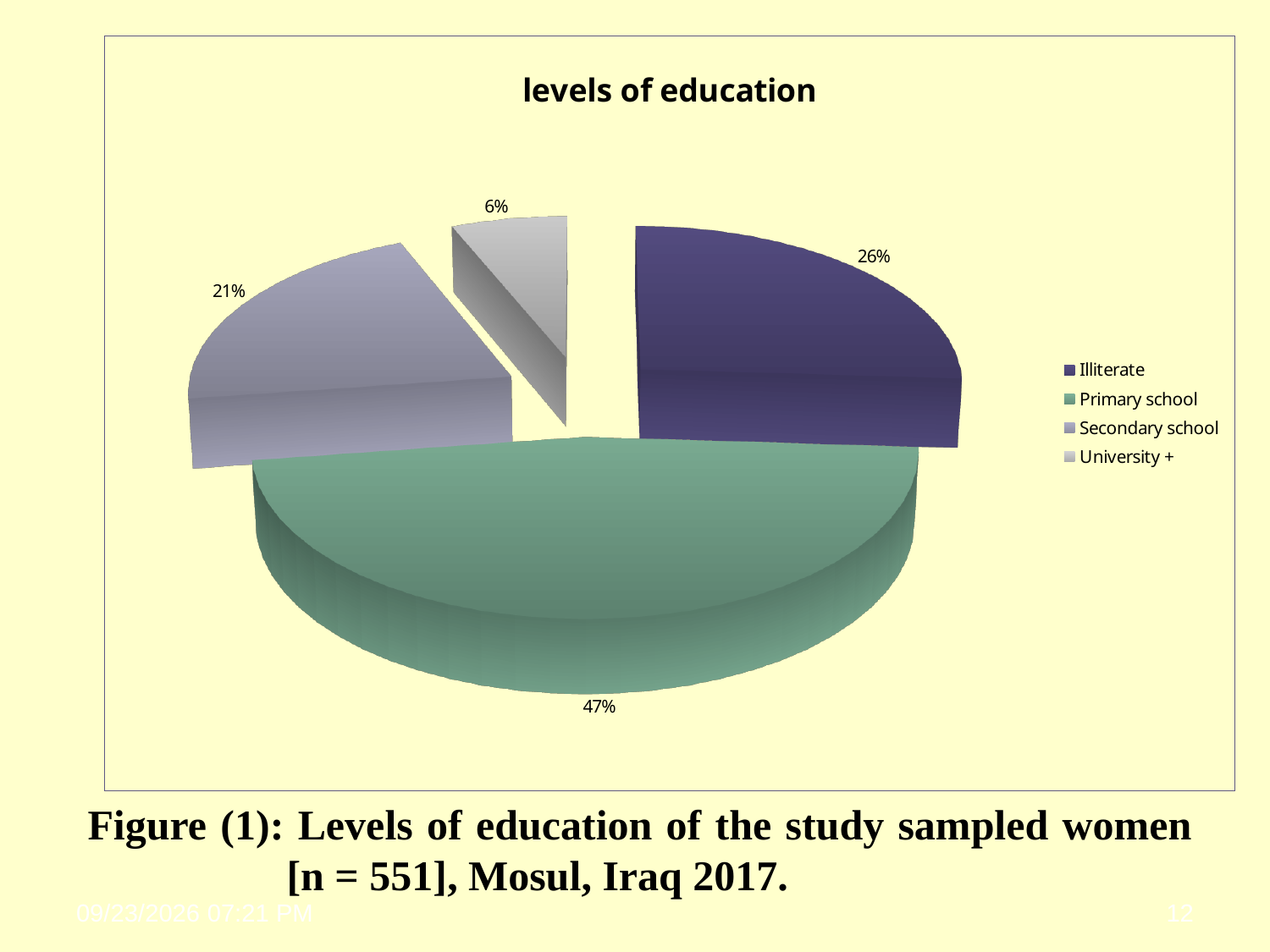
What percentage of the sampled women are illiterate? 26% What percentage of the sampled women have secondary school education? 21% Which level of education has the largest share of the pie? Primary school Which level of education has the smallest share of the pie? University + What is the title of the chart? levels of education How many slices does the pie chart have? 4 How many entries does the legend list? 4 Which slice is larger, Illiterate or Secondary school? Illiterate What percentage of the sampled women have primary school education? 47% What percentage of the sampled women have university or higher education? 6% What kind of chart is shown on the slide? pie chart What is the difference in percentage points between the Primary school and Illiterate slices? 21